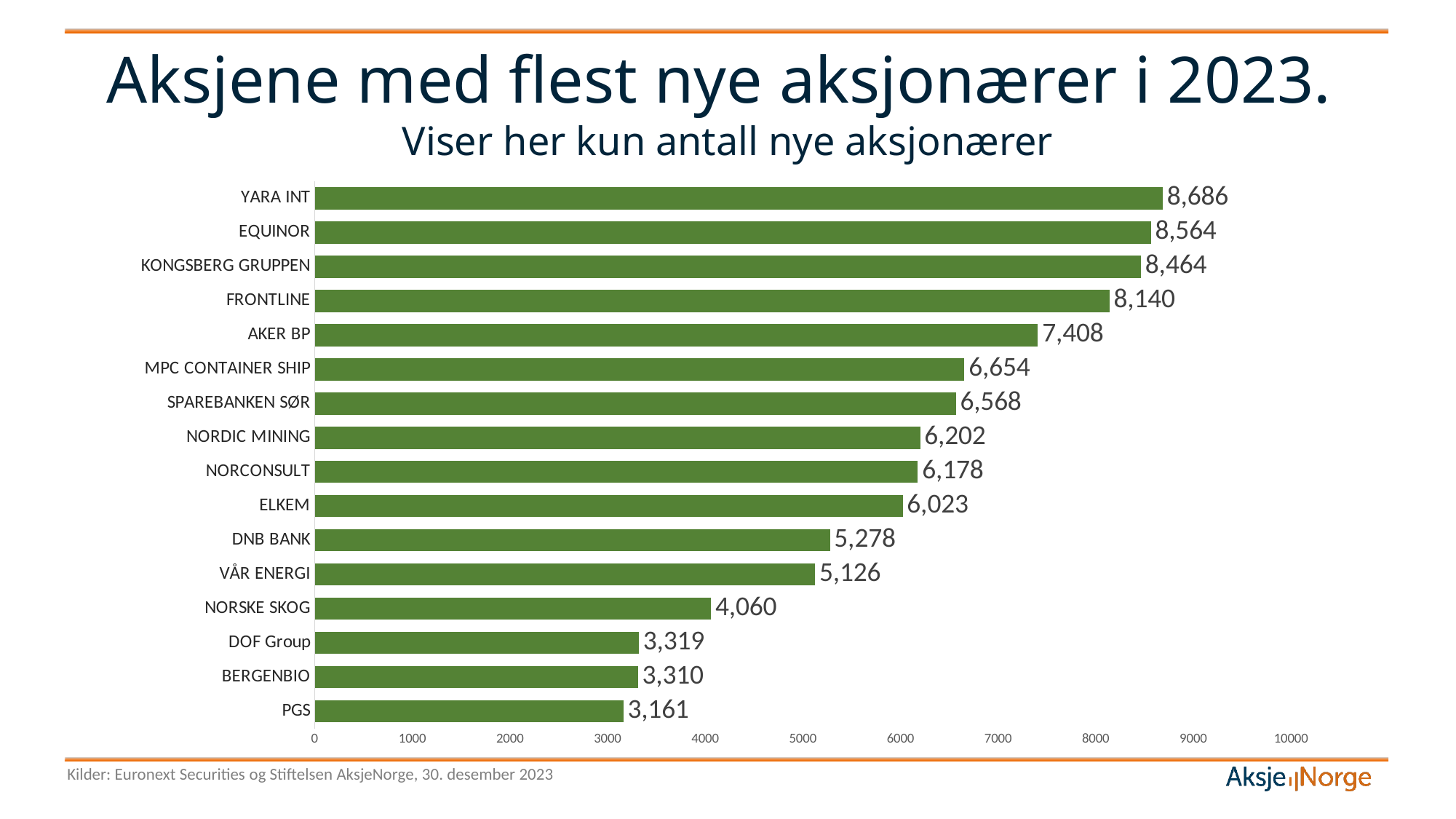
What kind of chart is shown on the slide? bar chart What is the value for YARA INT? 8,686 Is the value for ELKEM greater or less than 5000? greater What is the difference between the values for DNB BANK and VÅR ENERGI? 152 What is the difference between the values for YARA INT and EQUINOR? 122 What is the value for AKER BP? 7,408 What is the subtitle shown above the chart? Viser her kun antall nye aksjonærer Which category has the lowest value? PGS How many categories are shown in the chart? 16 Which is larger, the value for FRONTLINE or the value for AKER BP? FRONTLINE What is the value for NORSKE SKOG? 4,060 Which category has the highest value? YARA INT